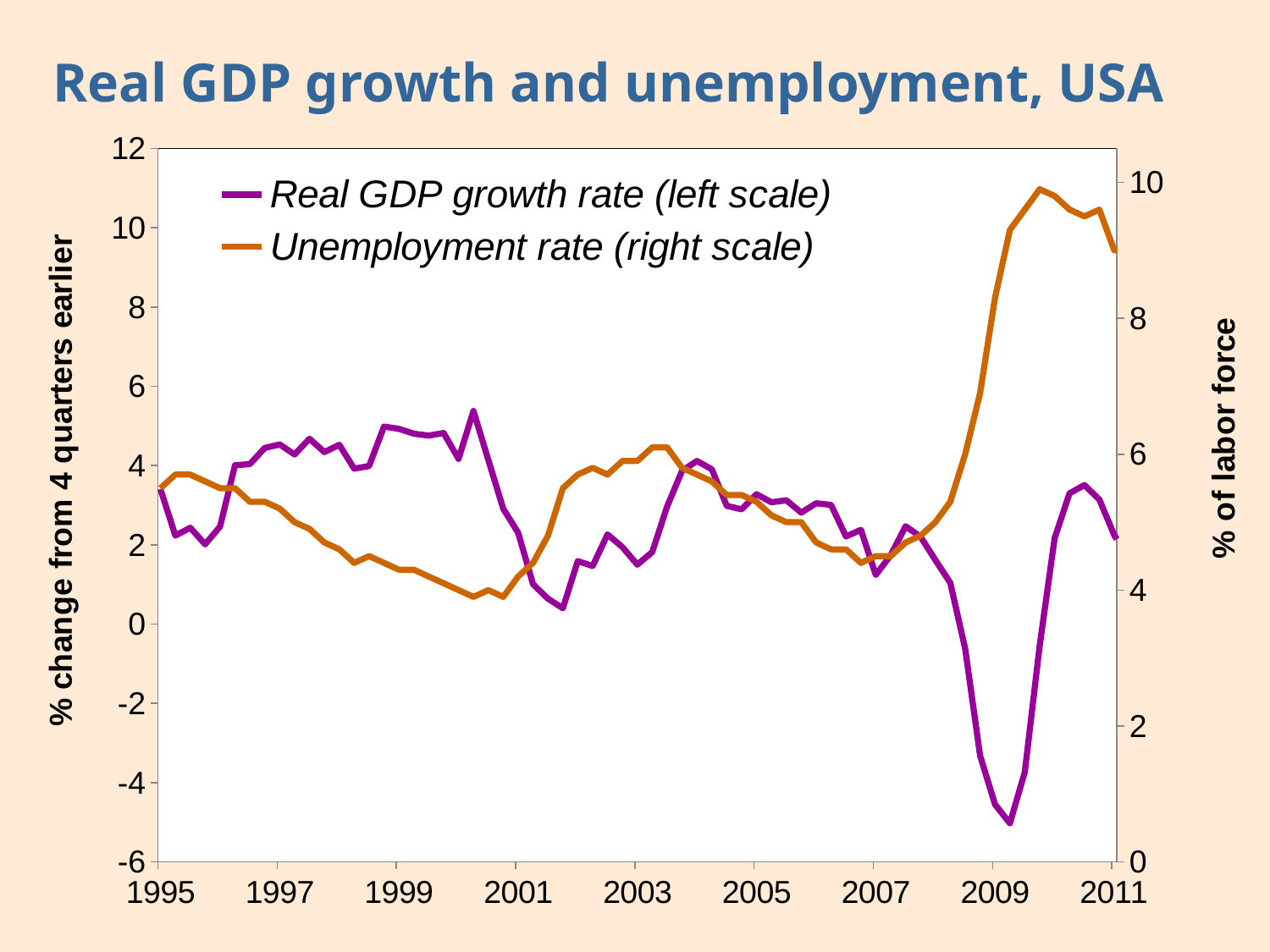
Between 2007 and 2009, does the unemployment rate rise or fall? rise Is the unemployment rate at 2001 greater or less than 6? less Is the unemployment rate higher at 2009 or at 2001? 2009 Is the real GDP growth rate at 1999 greater or less than 2? greater Between 2007 and 2009, does the real GDP growth rate rise or fall? fall How many series does the legend list? 2 Is the unemployment rate at 2007 greater or less than 6? less What kind of chart is shown on the slide? line chart Which colour is used for the Unemployment rate (right scale) series? orange What is the title of the chart? Real GDP growth and unemployment, USA